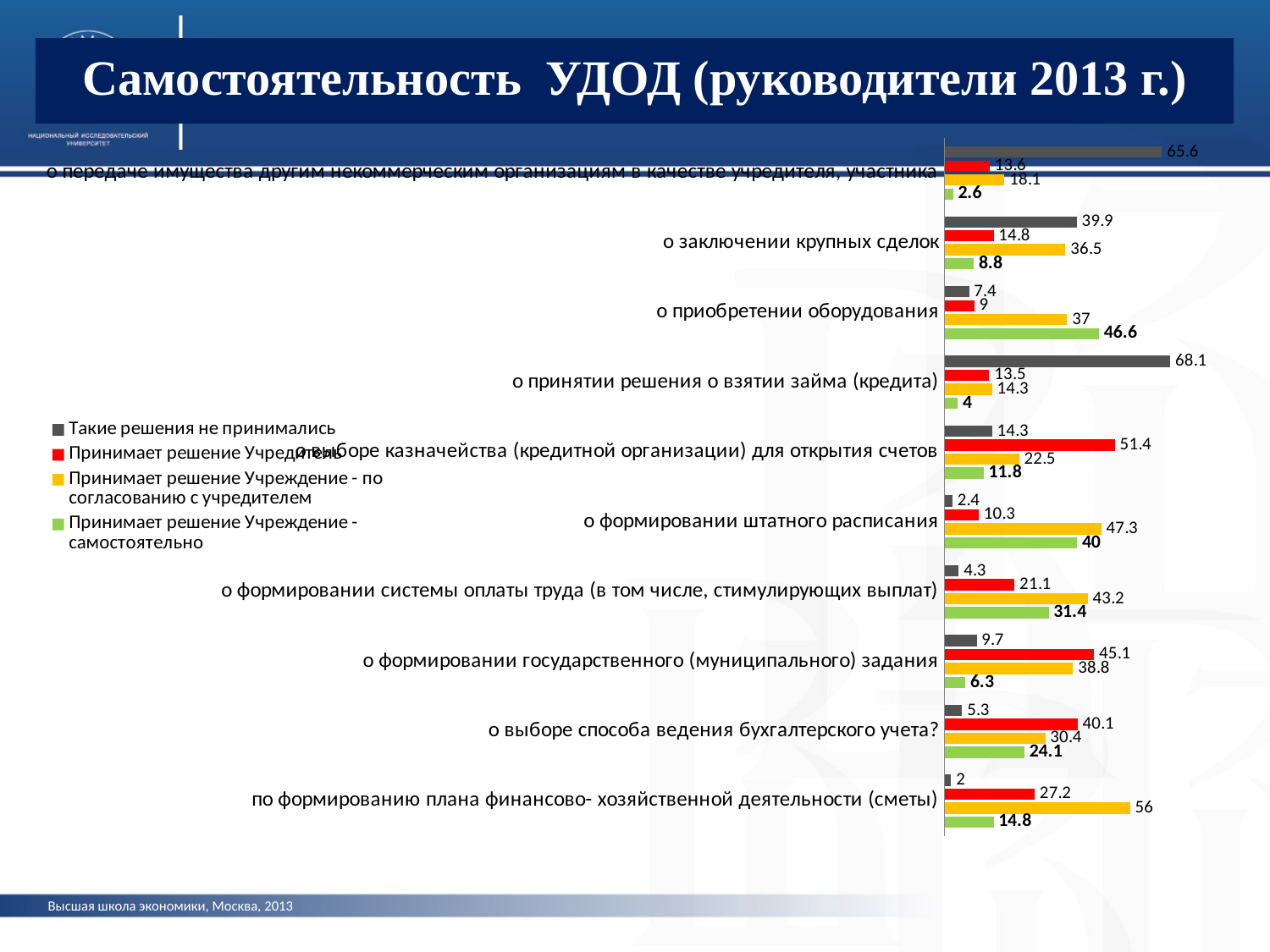
How many categories are plotted on the chart? 10 What is the value of "Такие решения не принимались" for "о принятии решения о взятии займа (кредита)"? 68.1 Which category has the highest value for "Такие решения не принимались"? о принятии решения о взятии займа (кредита) How many series does the legend list? 4 What is the value of "Принимает решение Учреждение - по согласованию с учредителем" for "по формированию плана финансово- хозяйственной деятельности (сметы)"? 56 What colour represents the series "Принимает решение Учредитель" in the legend? red For "о формировании штатного расписания", which is larger: "Принимает решение Учреждение - по согласованию с учредителем" or "Принимает решение Учреждение - самостоятельно"? Принимает решение Учреждение - по согласованию с учредителем What kind of chart is shown on the slide? bar chart Which category has the lowest value for "Такие решения не принимались"? по формированию плана финансово- хозяйственной деятельности (сметы) What is the value of "Принимает решение Учредитель" for "о выборе казначейства (кредитной организации) для открытия счетов"? 51.4 What is the difference between the "Принимает решение Учредитель" and "Принимает решение Учреждение - по согласованию с учредителем" values for "о формировании государственного (муниципального) задания"? 6.3 What is the value of "Принимает решение Учреждение - самостоятельно" for "о приобретении оборудования"? 46.6